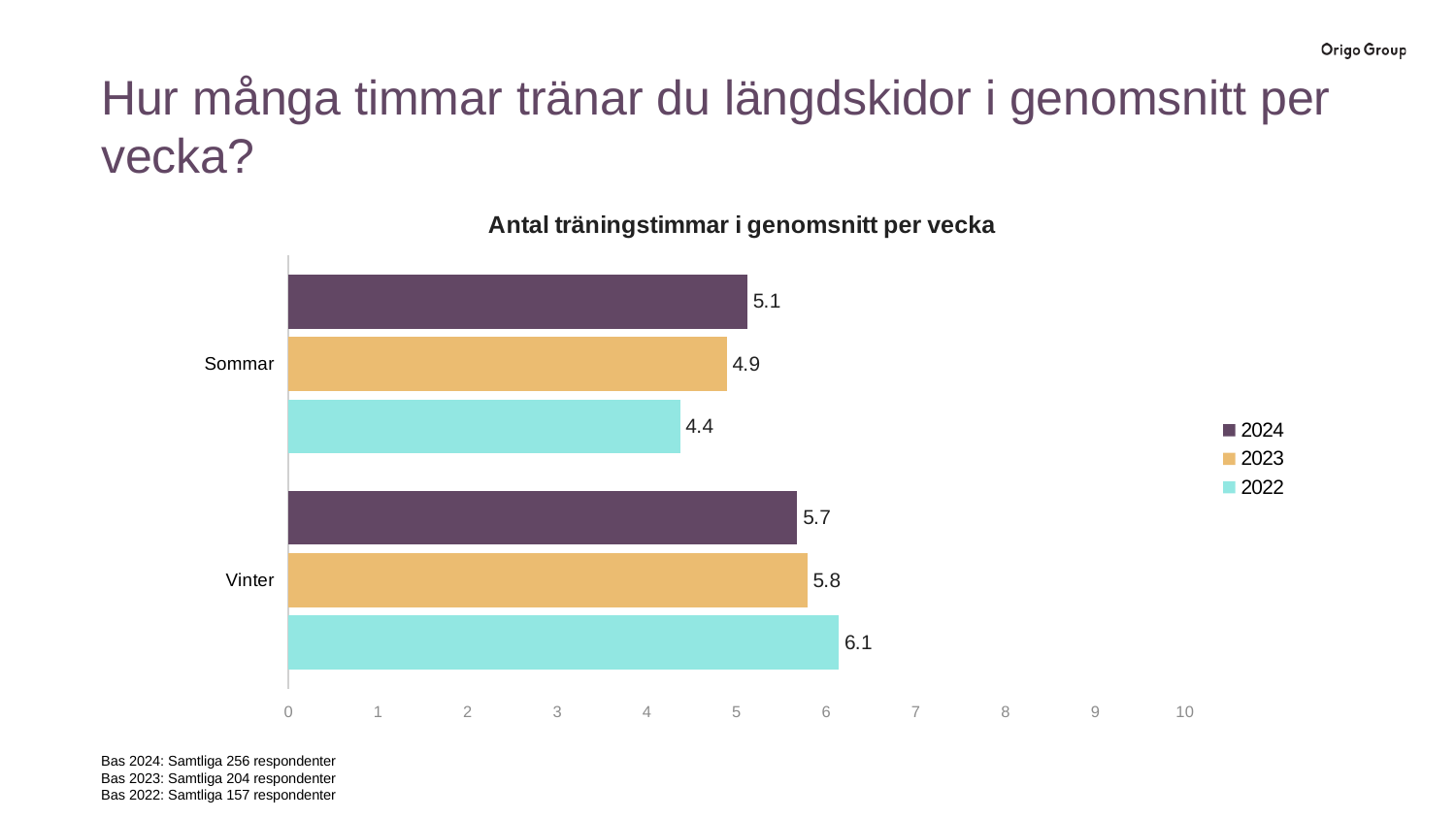
What is the title of the chart? Antal träningstimmar i genomsnitt per vecka What is the difference between the Vinter and Sommar values in the 2022 series? 1.7 Which is larger for Sommar: the 2024 value or the 2022 value? 2024 What is the value for Sommar in the 2024 series? 5.1 How many series does the legend list? 3 How many categories are shown on the chart? 2 Which category has the lowest value in the 2024 series? Sommar Which category has the highest value in the 2022 series? Vinter What kind of chart is shown on the slide? Bar chart What is the value for Vinter in the 2022 series? 6.1 What is the value for Sommar in the 2023 series? 4.9 Is the value for Vinter in the 2022 series greater or less than 5? greater